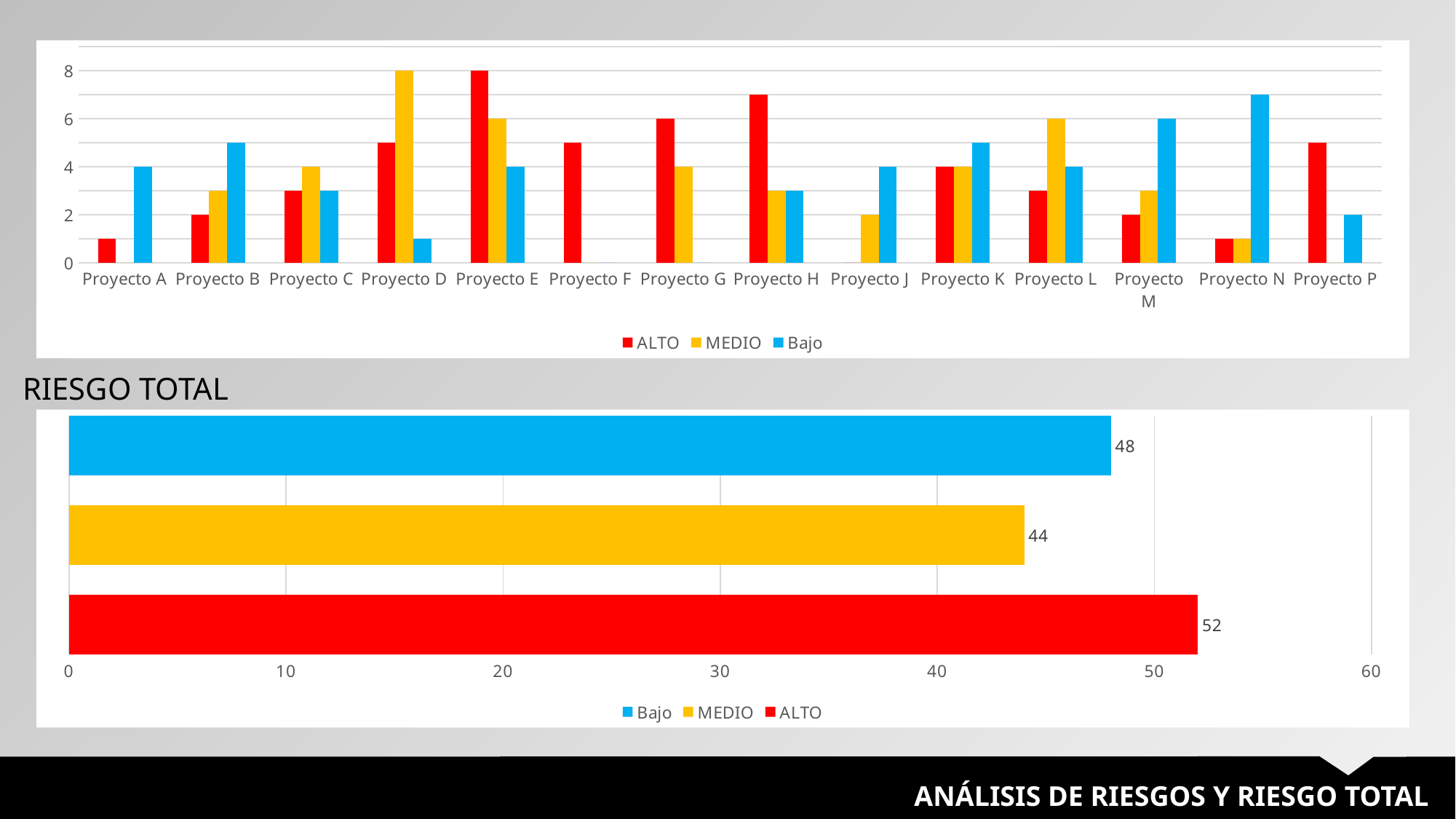
In the top chart, which project has the highest ALTO value? Proyecto E In the RIESGO TOTAL chart, which category has the lowest value? MEDIO In the top chart, is the Bajo value for Proyecto N greater or less than 6? greater What kind of chart is the RIESGO TOTAL chart? bar chart In the RIESGO TOTAL chart, what is the difference between ALTO and MEDIO? 8 In the top chart, how many series does the legend list? 3 In the RIESGO TOTAL chart, what is the value for ALTO? 52 In the top chart, what is the ALTO value for Proyecto E? 8 In the top chart, what is the Bajo value for Proyecto A? 4 In the RIESGO TOTAL chart, what is the value for Bajo? 48 In the top chart, what is the MEDIO value for Proyecto D? 8 In the RIESGO TOTAL chart, is the value for Bajo greater or less than 50? less